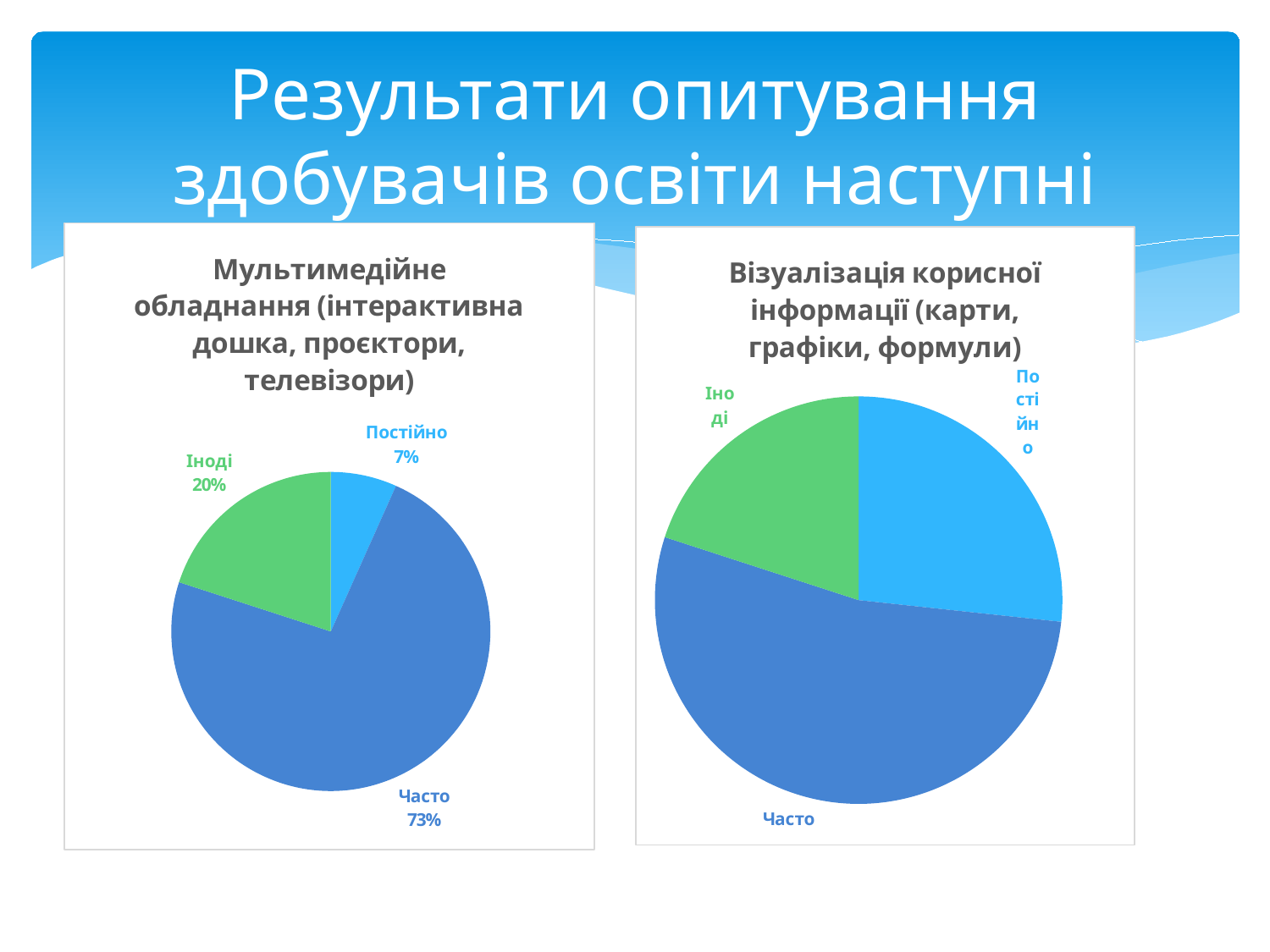
In the left chart (Мультимедійне обладнання), which category has the smallest slice? Постійно What is the title of the left chart? Мультимедійне обладнання (інтерактивна дошка, проєктори, телевізори) In the right chart (Візуалізація корисної інформації), which is larger, Часто or Іноді? Часто How many slices does the left chart (Мультимедійне обладнання) have? 3 In the left chart (Мультимедійне обладнання), what percentage is shown for Іноді? 20% In the left chart (Мультимедійне обладнання), which category has the largest slice? Часто In the right chart (Візуалізація корисної інформації), which category has the largest slice? Часто In the left chart (Мультимедійне обладнання), what percentage is shown for Постійно? 7% What type of chart is the right chart (Візуалізація корисної інформації)? Pie chart In the left chart (Мультимедійне обладнання), which is larger, Іноді or Постійно? Іноді In the left chart (Мультимедійне обладнання), what percentage is shown for Часто? 73% In the left chart (Мультимедійне обладнання), what is the difference in percentage points between Часто and Іноді? 53